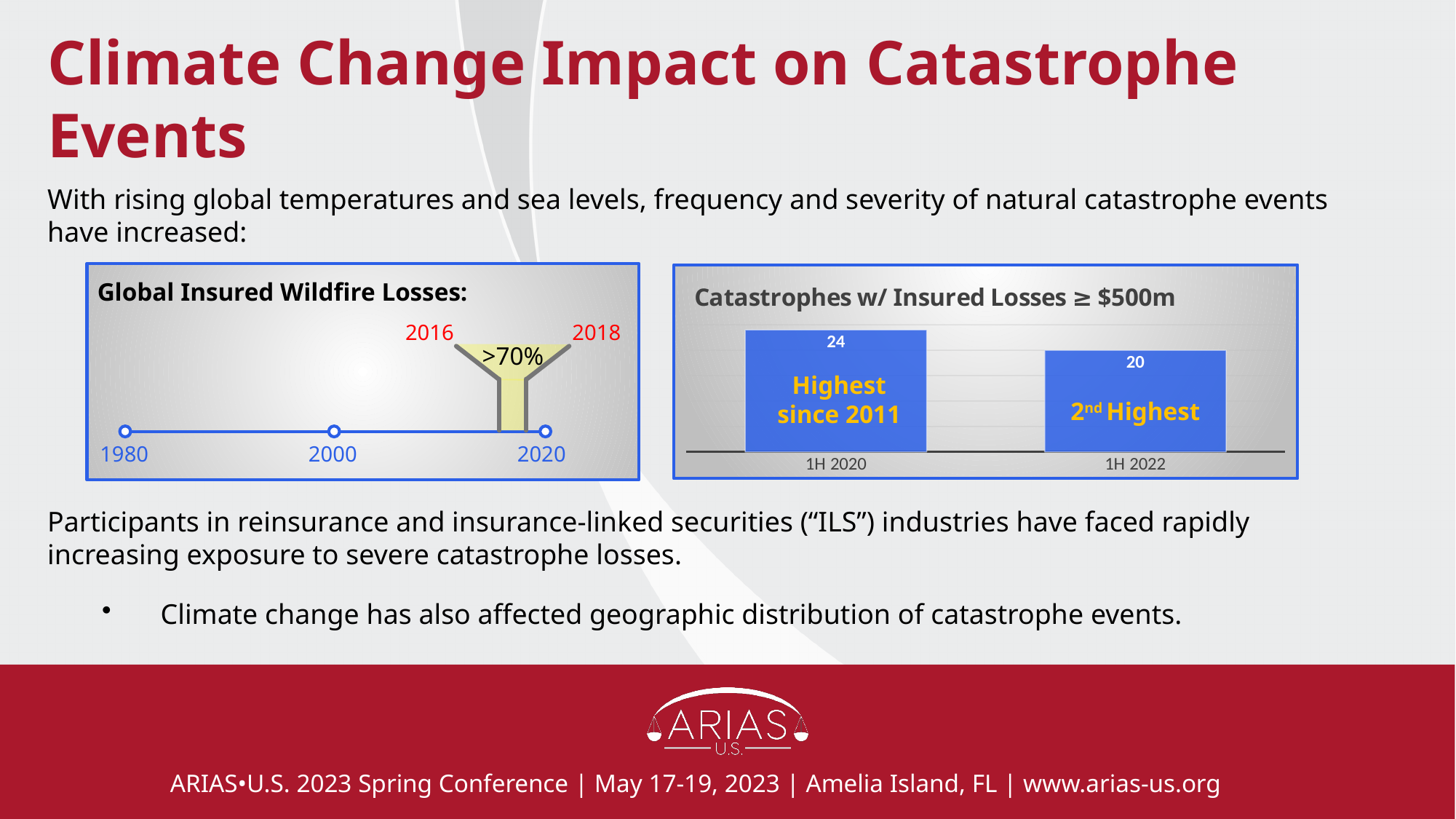
In the 'Catastrophes w/ Insured Losses ≥ $500m' chart, what is the difference between the 1H 2020 and 1H 2022 values? 4 In the 'Global Insured Wildfire Losses' chart on the left, what percentage is shown in the funnel between 2016 and 2018? >70% In the 'Global Insured Wildfire Losses' chart on the left, what are the three years marked on the timeline axis? 1980, 2000, 2020 In the 'Catastrophes w/ Insured Losses ≥ $500m' chart, which period has the lower value? 1H 2022 What kind of chart is the 'Catastrophes w/ Insured Losses ≥ $500m' chart? bar chart In the 'Catastrophes w/ Insured Losses ≥ $500m' chart, how many bars are shown? 2 In the 'Catastrophes w/ Insured Losses ≥ $500m' chart, what is the value for 1H 2022? 20 In the 'Catastrophes w/ Insured Losses ≥ $500m' chart, what is the value for 1H 2020? 24 In the 'Catastrophes w/ Insured Losses ≥ $500m' chart, do the values rise or fall from 1H 2020 to 1H 2022? fall In the 'Catastrophes w/ Insured Losses ≥ $500m' chart, is the value for 1H 2020 larger or smaller than the value for 1H 2022? larger In the 'Catastrophes w/ Insured Losses ≥ $500m' chart, what label is written inside the 1H 2020 bar? Highest since 2011 In the 'Catastrophes w/ Insured Losses ≥ $500m' chart, which period has the higher value? 1H 2020